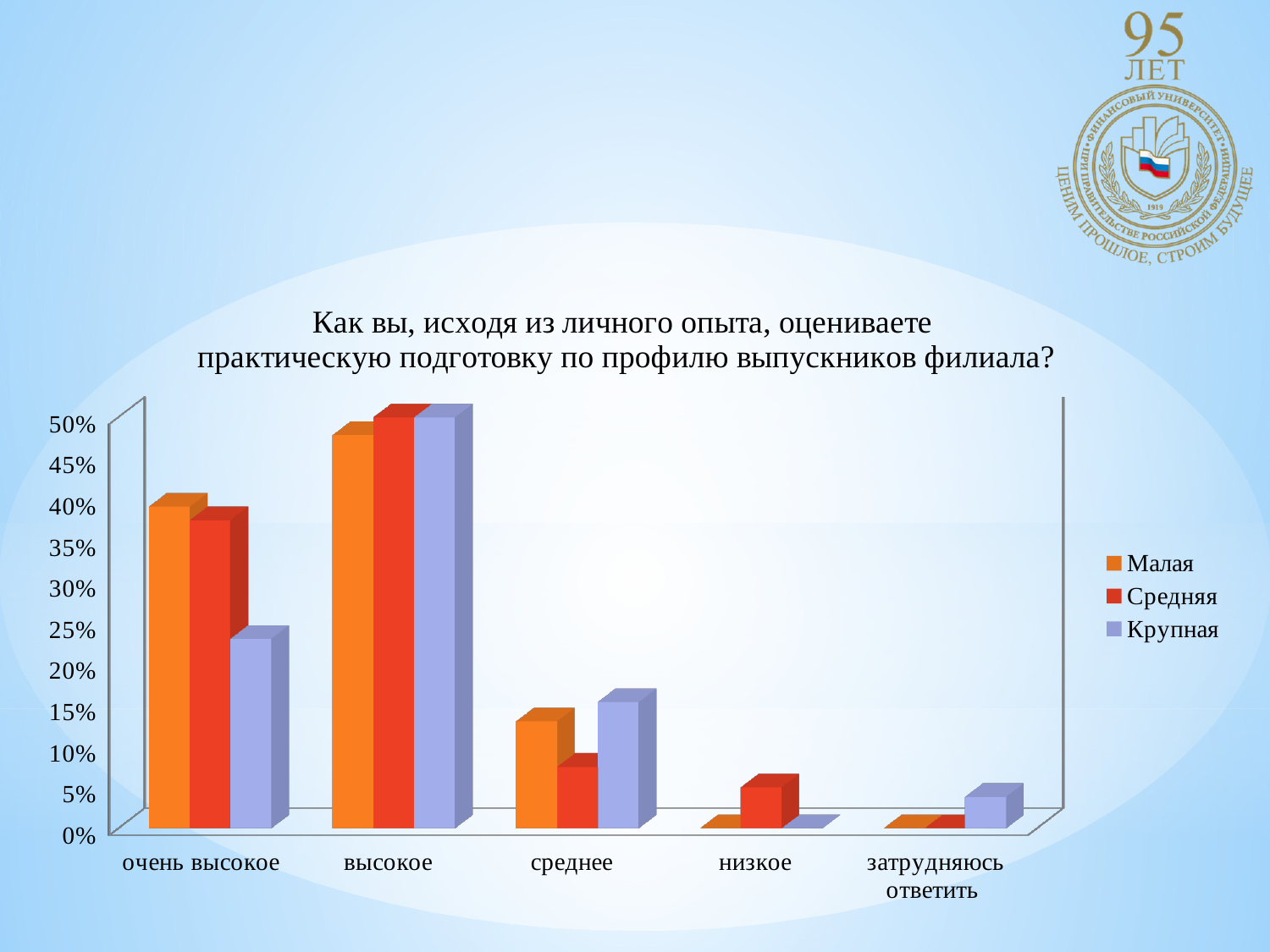
In the category 'очень высокое', which series has the lowest value? Крупная Is the value for Малая in the category 'высокое' greater or less than 40%? greater Which series are listed in the legend? Малая, Средняя, Крупная Is the value for Малая in the category 'очень высокое' greater or less than 30%? greater Is the value for Крупная in the category 'очень высокое' greater or less than 30%? less How many series does the legend list? 3 What kind of chart is shown on the slide? bar chart How many categories are shown on the x axis? 5 In which category does the Крупная series reach its highest value? высокое In the category 'среднее', which is larger: the value for Средняя or for Крупная? Крупная In the category 'очень высокое', which is larger: the value for Малая or for Крупная? Малая